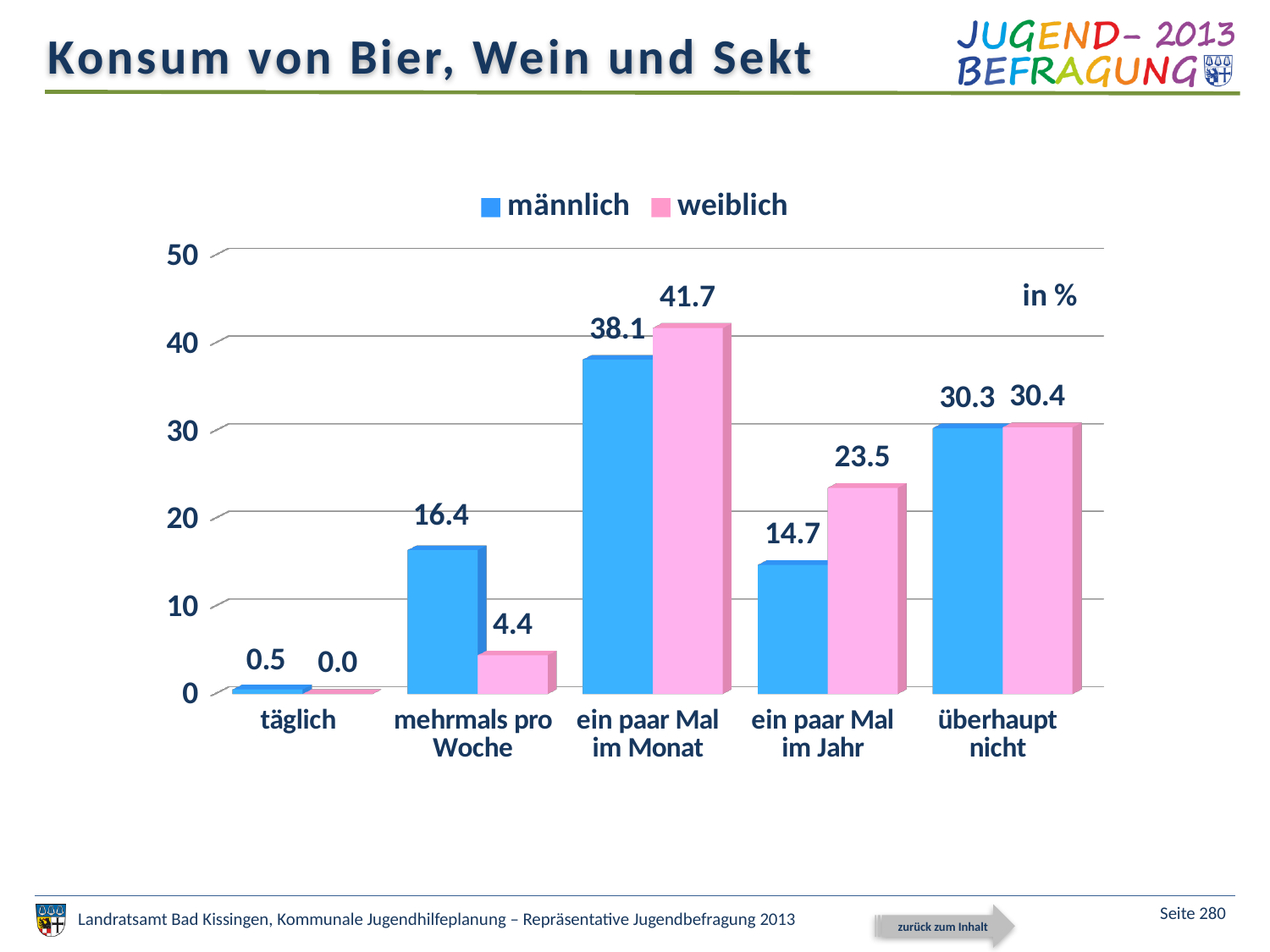
What is the difference between the männlich values for 'ein paar Mal im Monat' and 'mehrmals pro Woche'? 21.7 What is the value for männlich in the category 'ein paar Mal im Monat'? 38.1 What kind of chart is shown on the slide? bar chart Which category has the lowest value for männlich? täglich How many categories are shown on the x axis? 5 In the category 'mehrmals pro Woche', which series has the larger value, männlich or weiblich? männlich How many series does the legend list? 2 What unit is indicated for the values in the chart? in % What is the value for weiblich in the category 'mehrmals pro Woche'? 4.4 What is the difference between the weiblich and männlich values in the category 'ein paar Mal im Jahr'? 8.8 Which category has the highest value for weiblich? ein paar Mal im Monat What is the value for weiblich in the category 'täglich'? 0.0